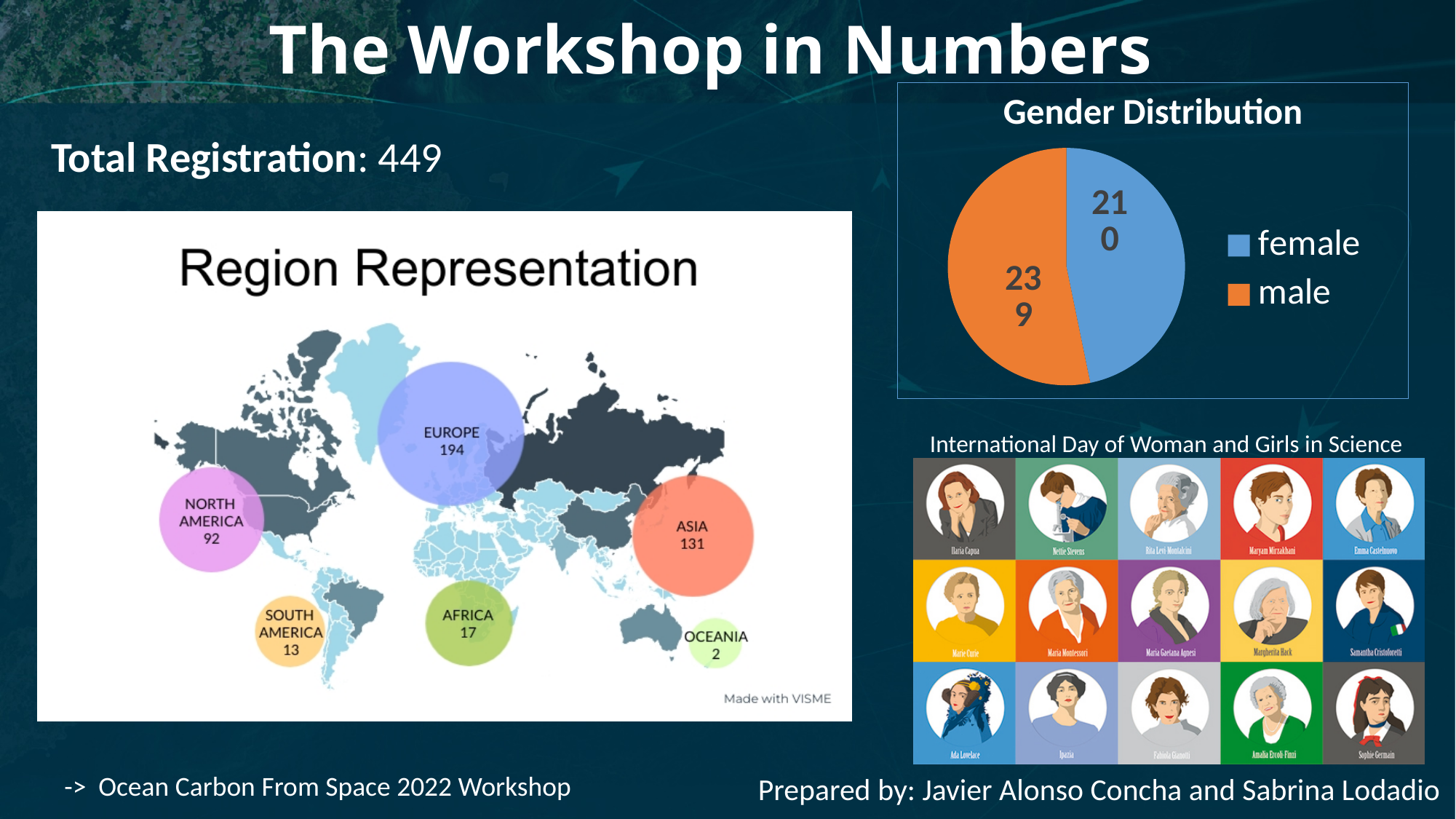
How many entries does the legend of the Gender Distribution chart list? 2 In the Gender Distribution pie chart, what is the difference between the male and female values? 29 What kind of chart is the Gender Distribution chart? pie chart In the Region Representation chart, what is the difference between Europe and Asia? 63 In the Gender Distribution pie chart, what is the value for male? 239 In the Gender Distribution pie chart, what colour is the male slice? orange In the Gender Distribution pie chart, which gender has the larger slice? male In the Gender Distribution pie chart, what is the total of the two slices? 449 In the Region Representation chart, which region has the lowest value? Oceania In the Region Representation chart, what is the value for Europe? 194 How many regions are shown in the Region Representation chart? 6 In the Gender Distribution pie chart, what is the value for female? 210